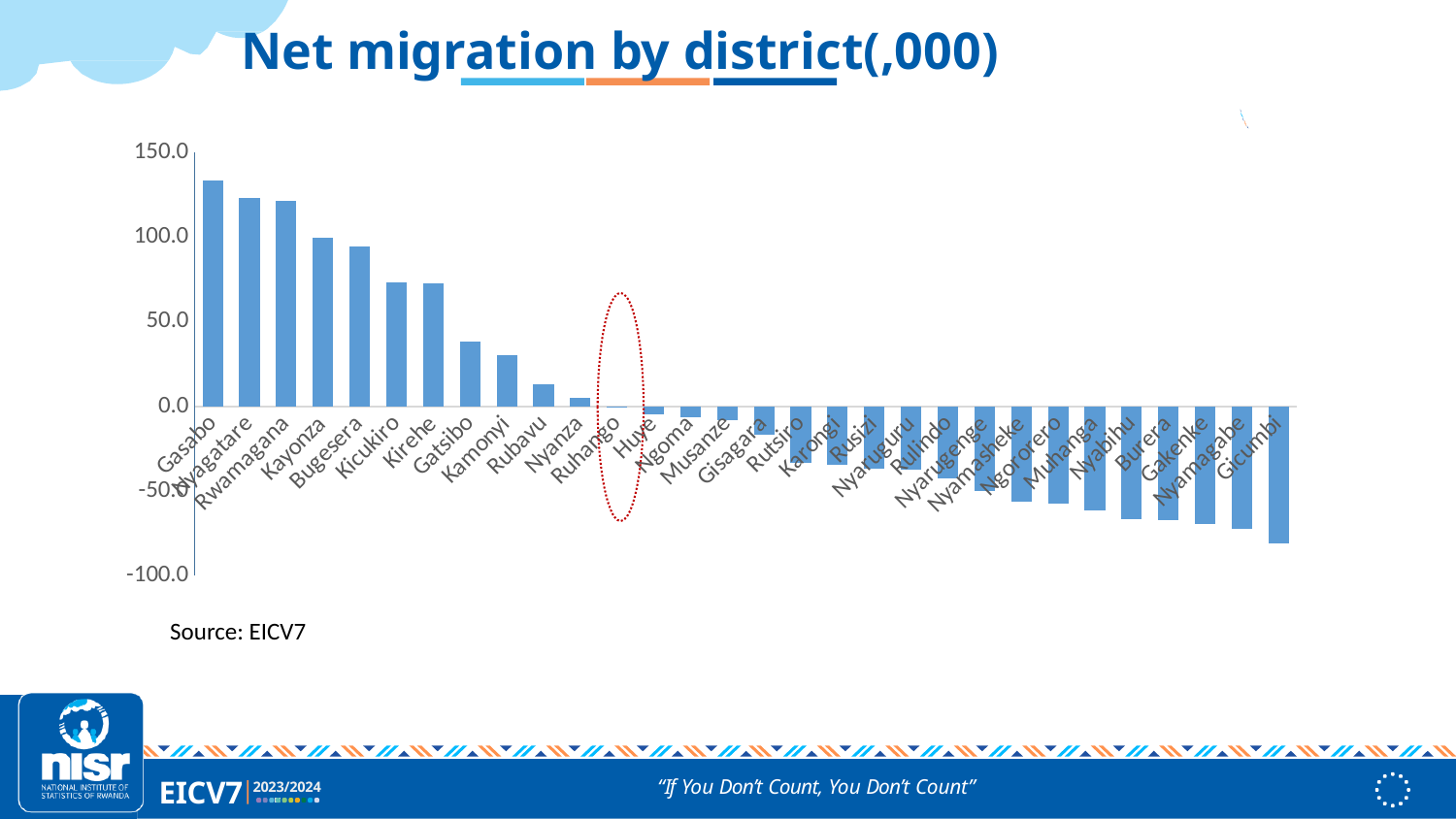
How many districts are shown on the x axis? 30 What is the title of the chart? Net migration by district(,000) Which district's bar is circled with a red dotted outline? Ruhango Which district has the highest net migration? Gasabo Which district has the lowest net migration? Gicumbi Is the value for Gasabo greater or less than 100.0? greater Is the value for Gatsibo greater or less than 50.0? less What kind of chart is shown on the slide? bar chart Which district has the larger net migration, Gasabo or Nyagatare? Gasabo Do the values rise or fall moving from left to right along the x axis? fall Is the value for Gicumbi greater or less than -50.0? less